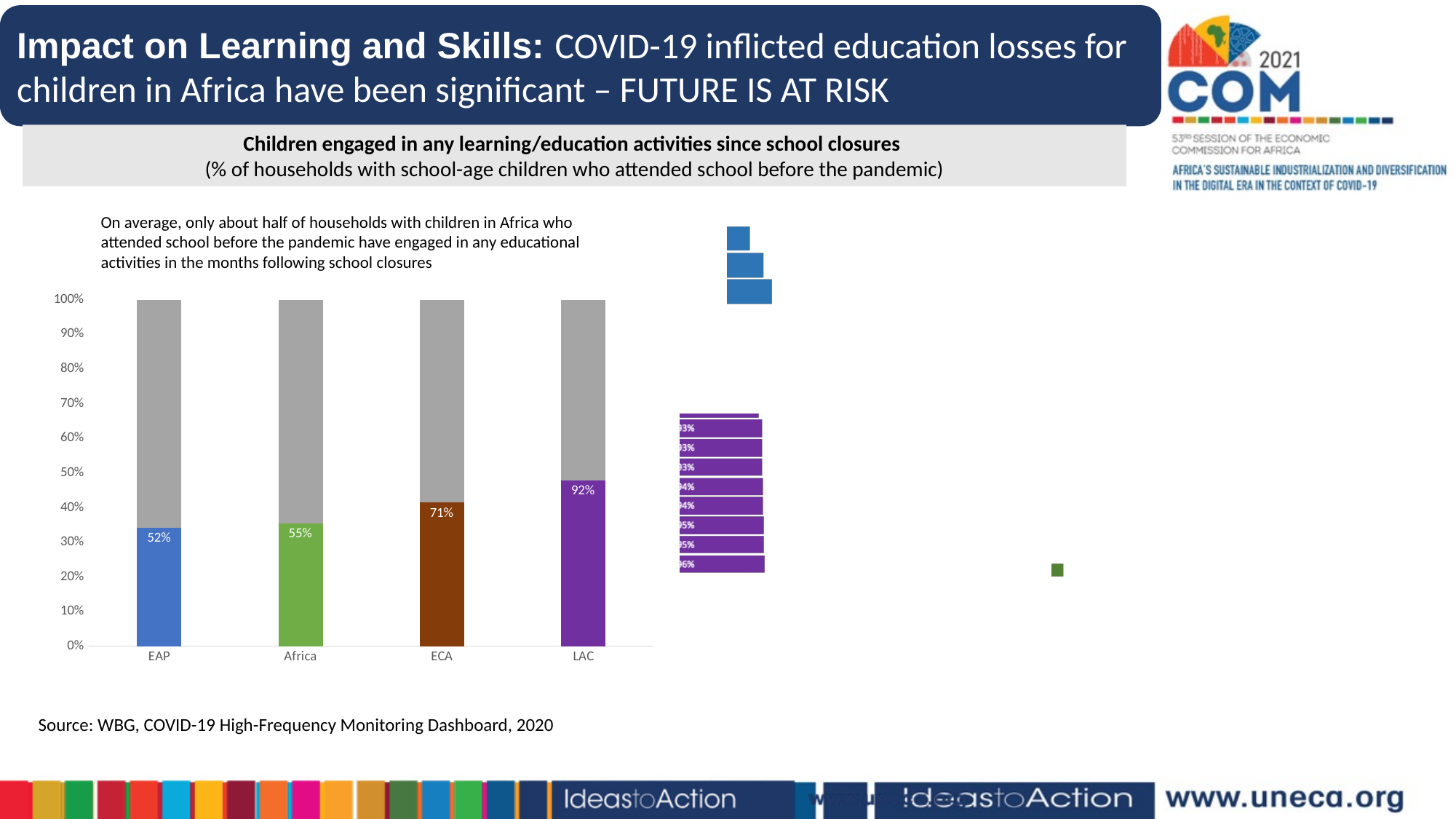
Which has a higher value in the bar chart, Africa or ECA? ECA Which region has the lowest share of children engaged in learning activities in the bar chart? EAP What is the value shown for LAC in the bar chart? 92% What type of chart is used to show children engaged in learning activities by region? Bar chart What is the difference between the values for LAC and EAP in the bar chart? 40 percentage points What is the difference between the values for ECA and Africa in the bar chart? 16 percentage points What is the value shown for ECA in the bar chart? 71% What is the value shown for EAP in the bar chart? 52% What is the value shown for Africa in the bar chart? 55% How many regions are shown on the x axis of the bar chart? 4 Which region has the highest share of children engaged in learning activities in the bar chart? LAC What is the title of the chart on the slide? Children engaged in any learning/education activities since school closures